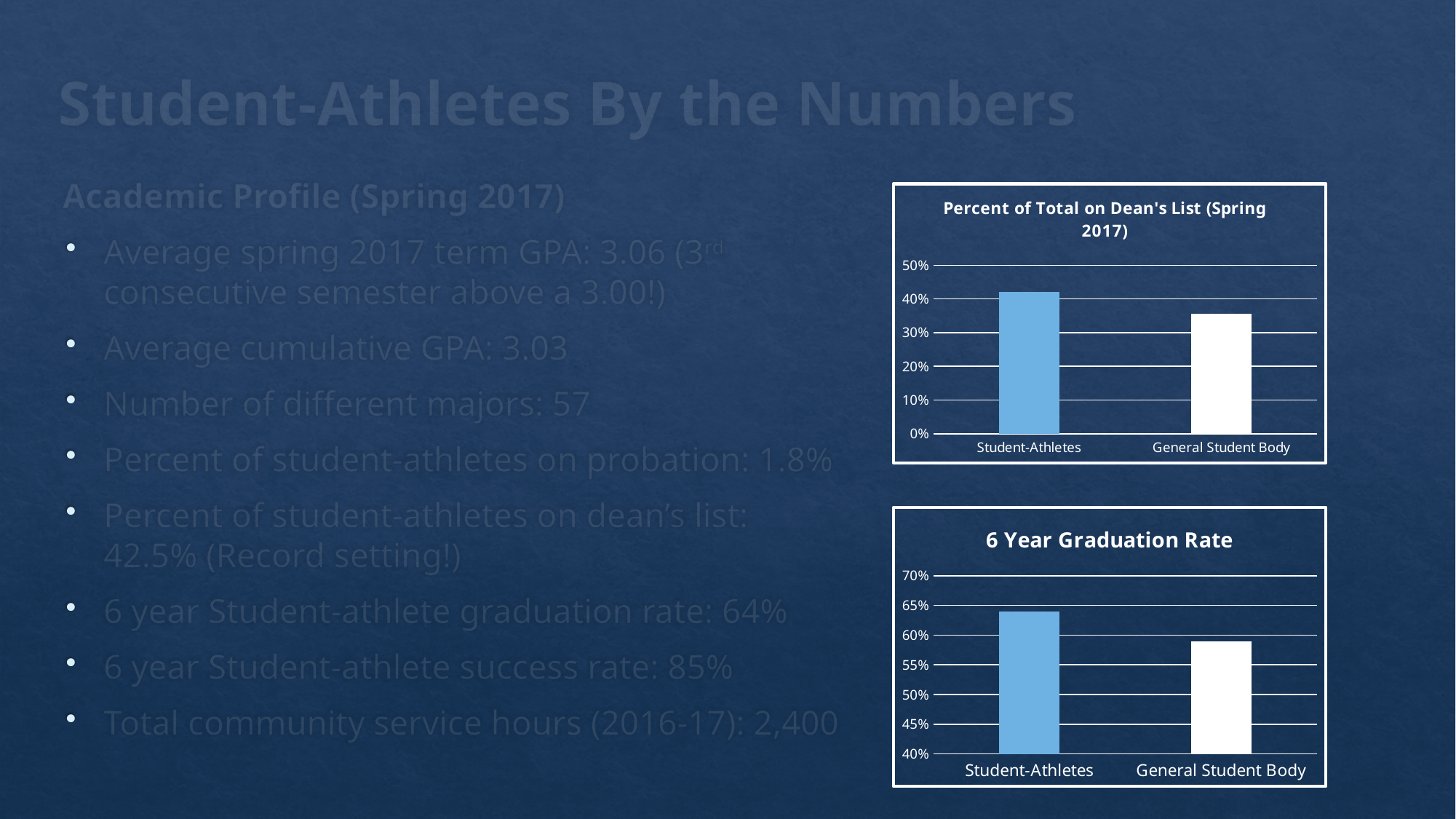
In the 'Percent of Total on Dean's List (Spring 2017)' chart, how many categories are shown? 2 In the '6 Year Graduation Rate' chart, is the value for General Student Body greater or less than 60%? less In the 'Percent of Total on Dean's List (Spring 2017)' chart, is the value for General Student Body greater or less than 40%? less What is the title of the lower chart on the slide? 6 Year Graduation Rate In the '6 Year Graduation Rate' chart, which category has the lowest value? General Student Body In the '6 Year Graduation Rate' chart, what colour is the Student-Athletes bar? Light blue In the 'Percent of Total on Dean's List (Spring 2017)' chart, which category has the lowest value? General Student Body In the '6 Year Graduation Rate' chart, which category has the higher value, Student-Athletes or General Student Body? Student-Athletes What kind of chart is the 'Percent of Total on Dean's List (Spring 2017)' chart? Bar chart In the 'Percent of Total on Dean's List (Spring 2017)' chart, is the value for Student-Athletes greater or less than 40%? greater In the 'Percent of Total on Dean's List (Spring 2017)' chart, which category has the highest value? Student-Athletes